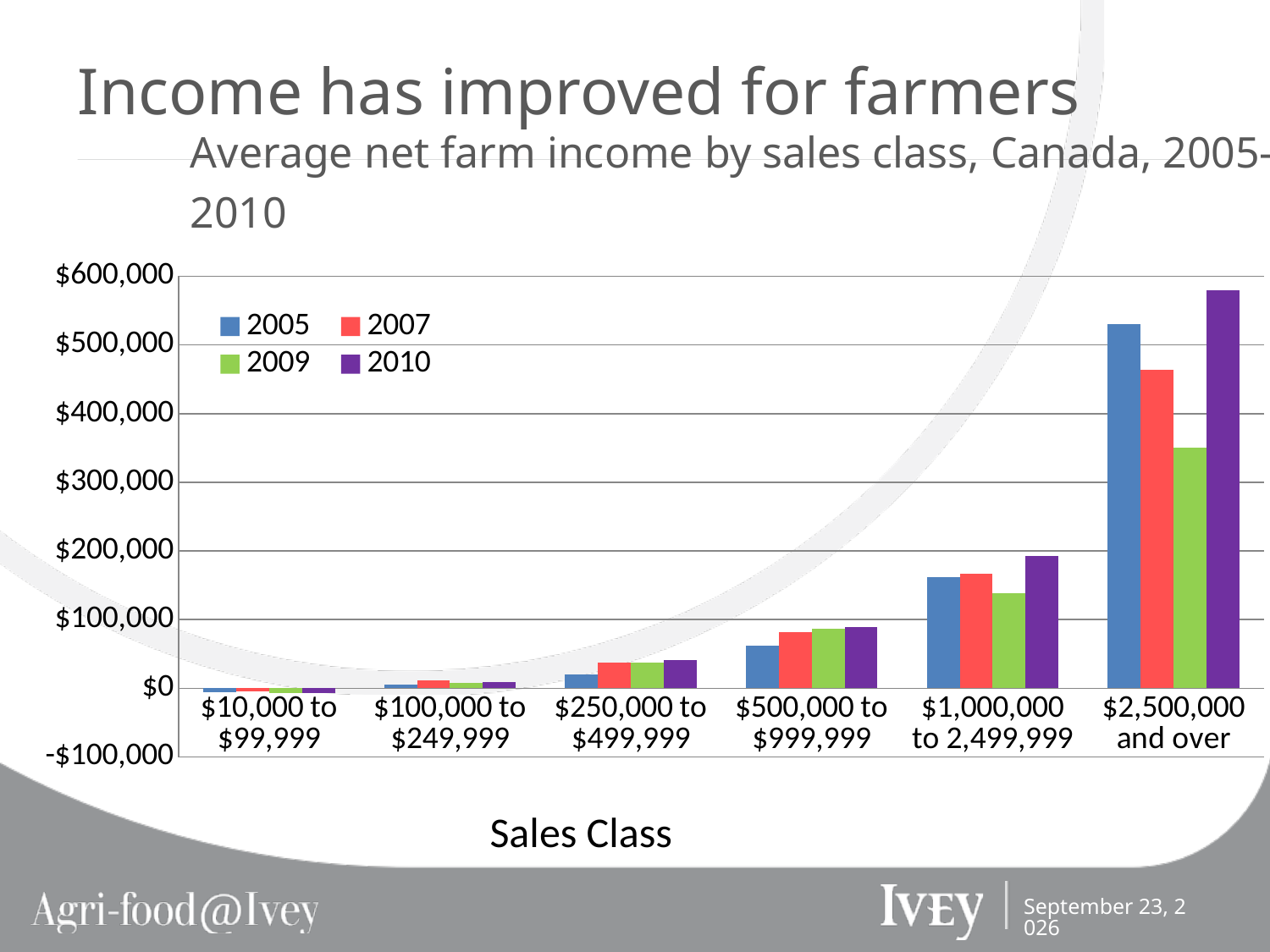
How many series does the legend list? 4 How many sales classes are shown on the x axis? 6 In the $2,500,000 and over sales class, which is larger: the 2005 value or the 2009 value? 2005 What is the title of the x axis? Sales Class Is the 2005 value for the $1,000,000 to 2,499,999 sales class greater or less than $100,000? greater Which year has the lowest average net farm income in the $2,500,000 and over sales class? 2009 Is the 2010 value for the $2,500,000 and over sales class greater or less than $500,000? greater Is the 2009 value for the $2,500,000 and over sales class greater or less than $400,000? less Which year has the highest average net farm income in the $2,500,000 and over sales class? 2010 Do the 2010 values rise or fall as the sales class increases along the x axis? rise What kind of chart is shown on the slide? bar chart Which sales class has the lowest average net farm income across all years? $10,000 to $99,999